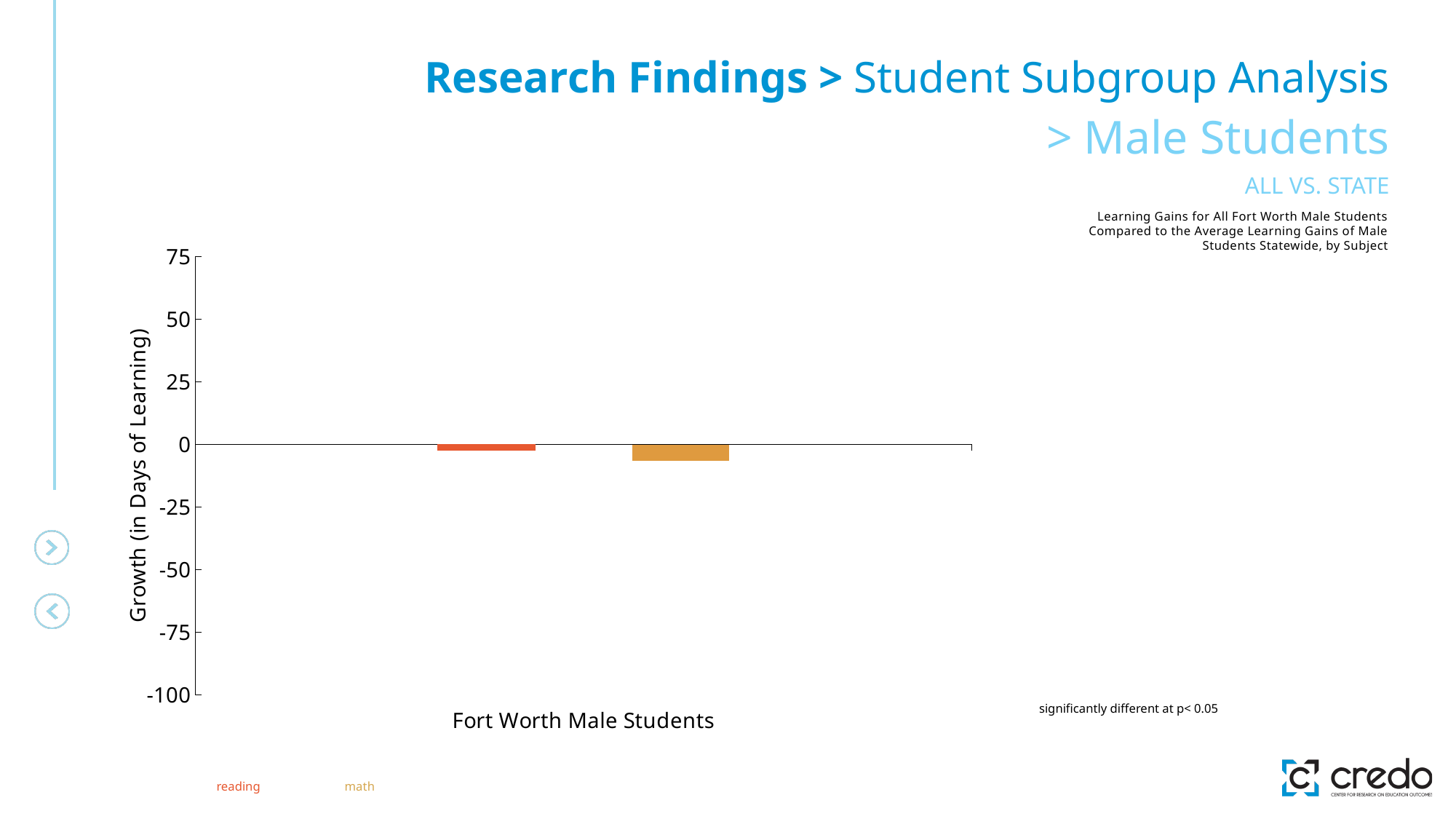
Is the value for reading greater or less than 0? less Is the value for reading greater or less than -25? greater How many series does the legend list? 2 Which series has the lower value, reading or math? math What is the label of the y axis? Growth (in Days of Learning) Is the value for math greater or less than -25? greater What kind of chart is shown on the slide? bar chart What is the category label shown on the x axis? Fort Worth Male Students Which series has the highest value? reading How many categories are shown on the x axis? 1